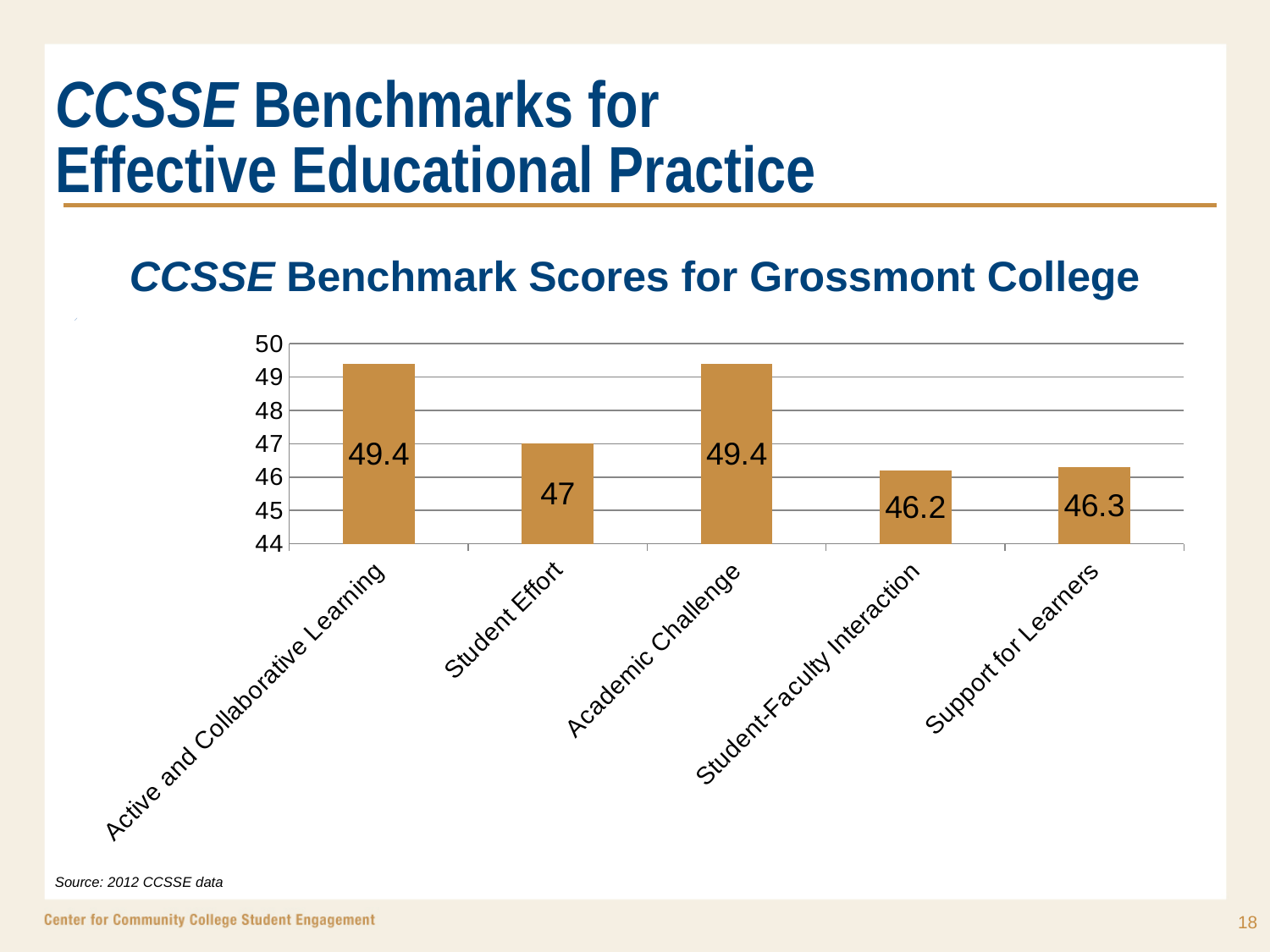
What is the benchmark score for Student-Faculty Interaction? 46.2 What is the benchmark score for Support for Learners? 46.3 What is the title of the chart? CCSSE Benchmark Scores for Grossmont College Which is larger, the score for Student Effort or the score for Support for Learners? Student Effort Is the value for Academic Challenge greater or less than 48? greater What is the difference between the scores for Support for Learners and Student-Faculty Interaction? 0.1 What is the benchmark score for Academic Challenge? 49.4 What is the difference between the scores for Active and Collaborative Learning and Student Effort? 2.4 What kind of chart is shown on the slide? Bar chart Which benchmark has the lowest score? Student-Faculty Interaction How many benchmark categories are shown in the chart? 5 What is the benchmark score for Student Effort? 47